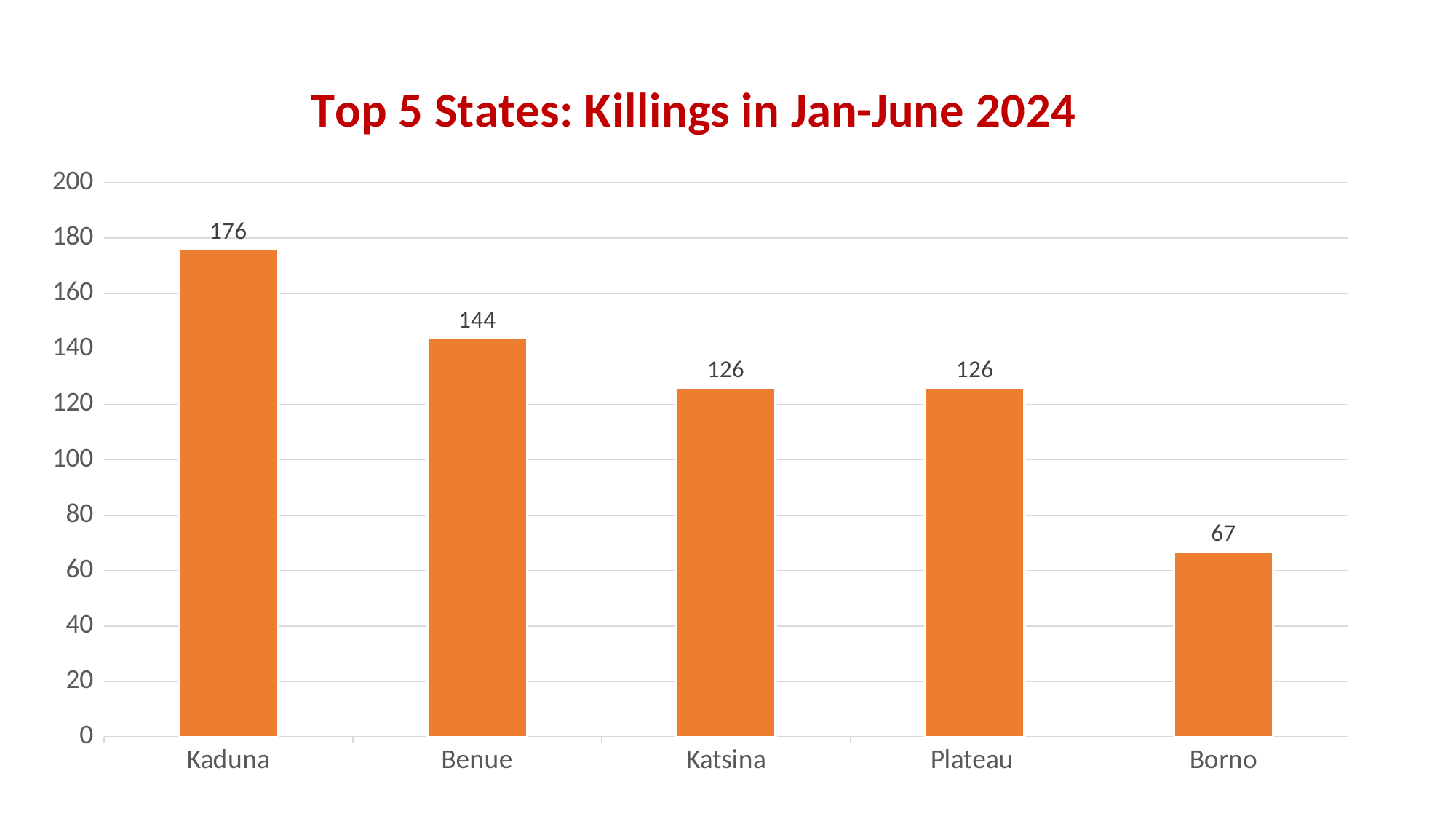
What is the difference between the values for Kaduna and Benue? 32 What is the title of the chart? Top 5 States: Killings in Jan-June 2024 How many states are shown on the chart? 5 Which state has the lowest value? Borno Which state has the highest value? Kaduna What is the value for Borno? 67 Which is larger, the value for Benue or the value for Katsina? Benue Is the value for Borno greater or less than 80? less What is the difference between the values for Plateau and Borno? 59 What kind of chart is this? bar chart What is the value for Kaduna? 176 What is the value for Benue? 144